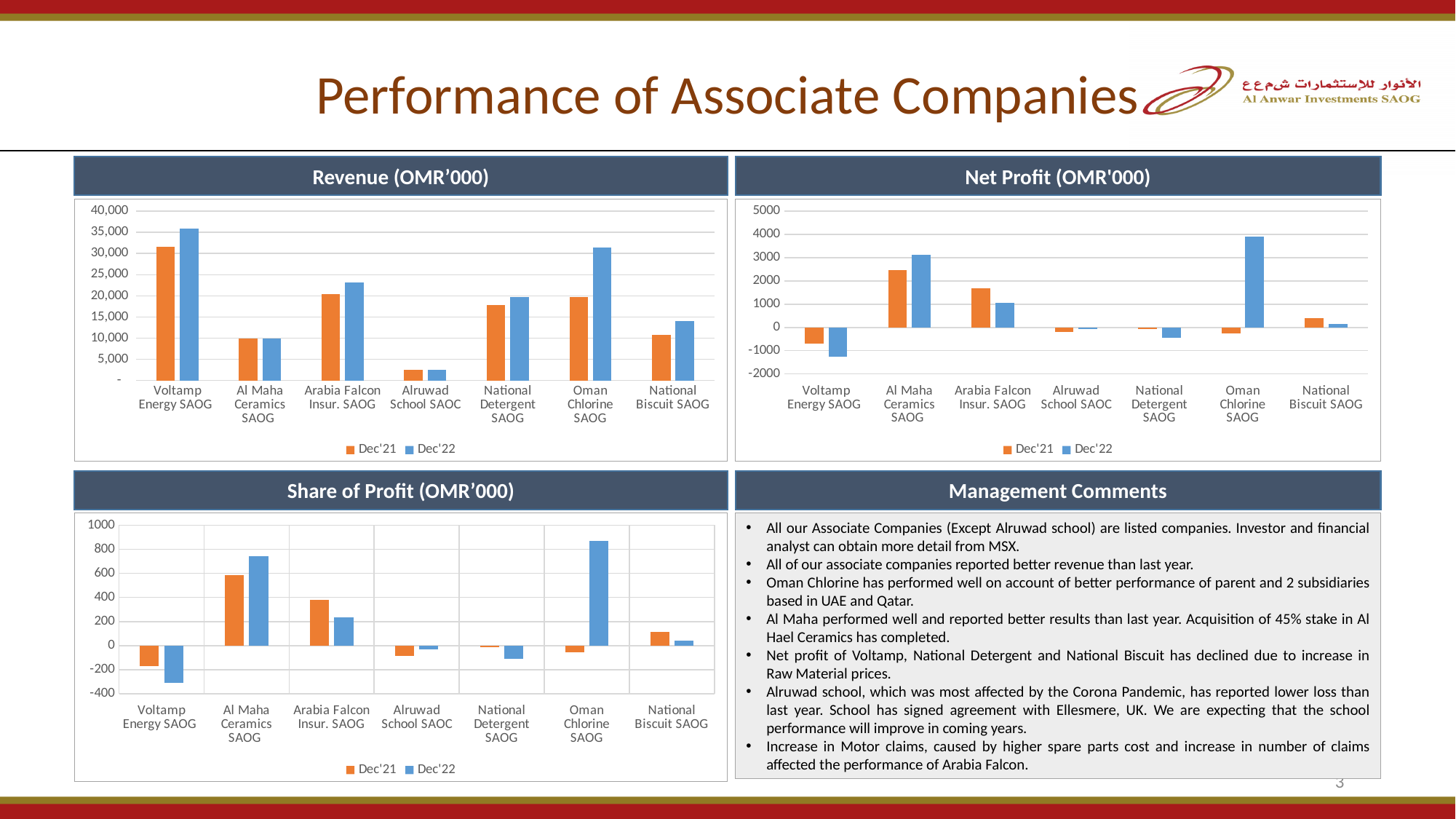
In the Revenue (OMR'000) chart, is the Dec'21 value for Voltamp Energy SAOG greater or less than 30,000? greater How many companies are shown on the x axis of the Revenue (OMR'000) chart? 7 In the Net Profit (OMR'000) chart, which company has the highest Dec'22 net profit? Oman Chlorine SAOG In the Revenue (OMR'000) chart, is the Dec'22 value for Arabia Falcon Insur. SAOG greater or less than 20,000? greater In the Net Profit (OMR'000) chart, for Arabia Falcon Insur. SAOG, which is larger: the Dec'21 value or the Dec'22 value? Dec'21 What kind of chart is the Share of Profit (OMR'000) chart? bar chart In the Share of Profit (OMR'000) chart, which company has the highest Dec'22 share of profit? Oman Chlorine SAOG How many series does the legend of the Net Profit (OMR'000) chart list? 2 In the Revenue (OMR'000) chart, which company has the highest Dec'22 revenue? Voltamp Energy SAOG In the Net Profit (OMR'000) chart, is the Dec'21 value for Al Maha Ceramics SAOG greater or less than 2000? greater In the Revenue (OMR'000) chart, which company has the lowest Dec'22 revenue? Alruwad School SAOC In the Net Profit (OMR'000) chart, which company has the lowest Dec'22 net profit? Voltamp Energy SAOG